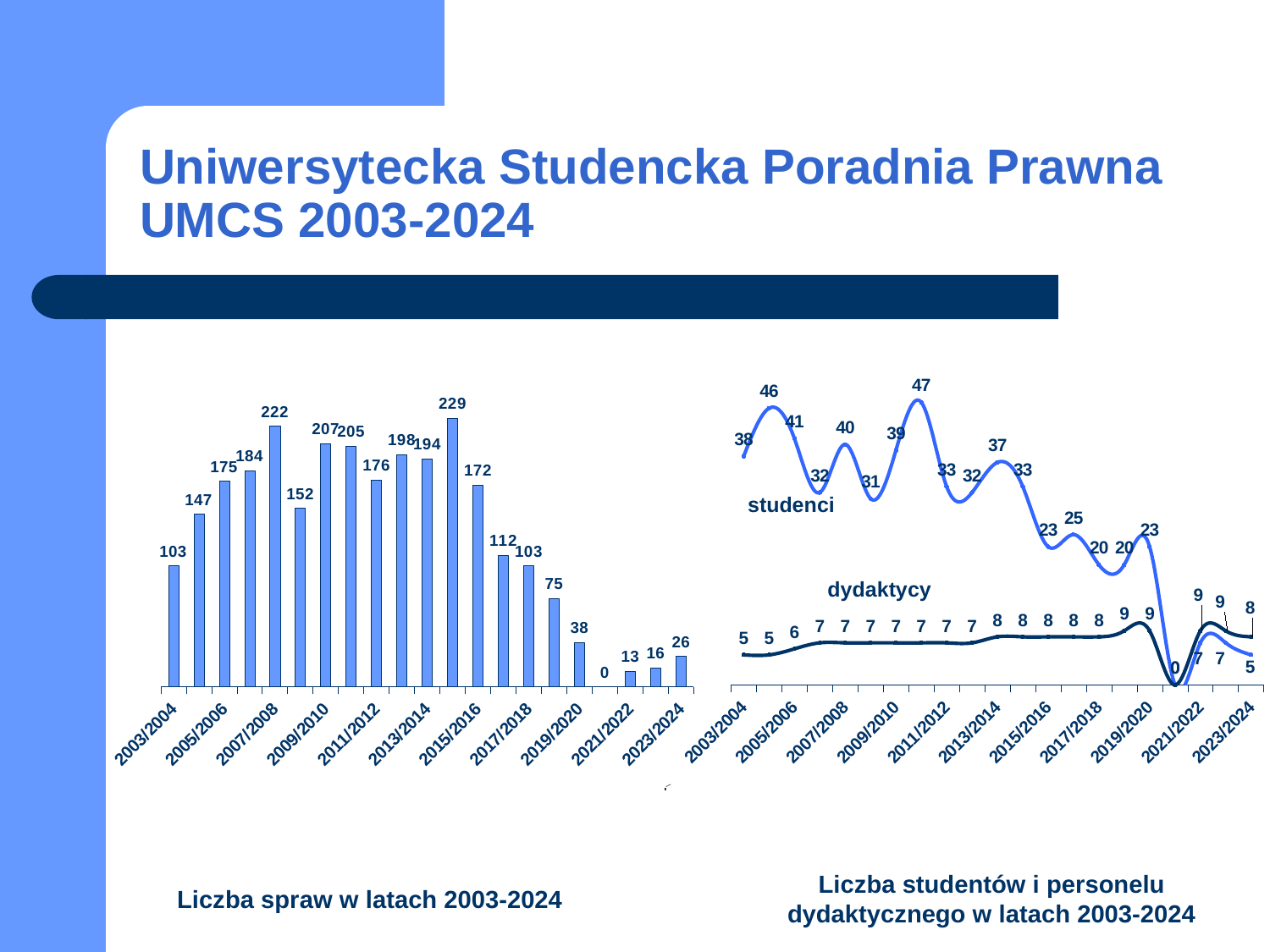
In the chart 'Liczba spraw w latach 2003-2024', how many bars are plotted? 21 In the chart 'Liczba studentów i personelu dydaktycznego w latach 2003-2024', what kind of chart is used? line chart In the chart 'Liczba spraw w latach 2003-2024', what is the value for 2007/2008? 222 In the chart 'Liczba spraw w latach 2003-2024', which year has the highest value? 2014/2015 In the chart 'Liczba spraw w latach 2003-2024', what is the difference between the values for 2003/2004 and 2023/2024? 77 In the chart 'Liczba studentów i personelu dydaktycznego w latach 2003-2024', what is the value for dydaktycy in 2023/2024? 8 In the chart 'Liczba studentów i personelu dydaktycznego w latach 2003-2024', what is the highest value of the studenci series? 47 In the chart 'Liczba studentów i personelu dydaktycznego w latach 2003-2024', how many series are plotted? 2 In the chart 'Liczba spraw w latach 2003-2024', which is larger, the value for 2009/2010 or the value for 2011/2012? 2009/2010 In the chart 'Liczba spraw w latach 2003-2024', which year has the lowest value? 2020/2021 In the chart 'Liczba spraw w latach 2003-2024', what kind of chart is used? bar chart In the chart 'Liczba studentów i personelu dydaktycznego w latach 2003-2024', what is the value for studenci in 2003/2004? 38